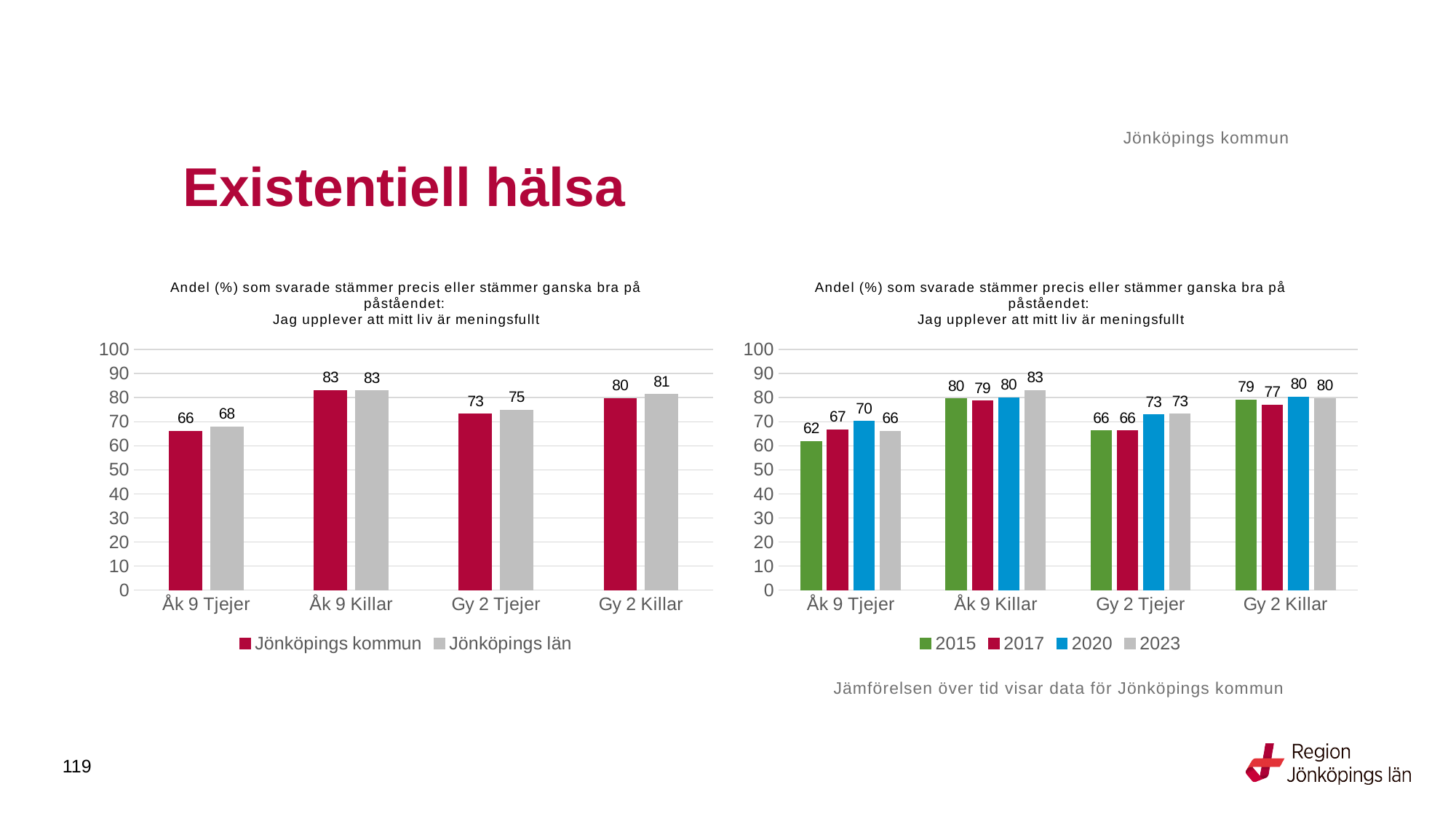
What kind of chart is the right chart? Bar chart In the left chart, what is the value for Jönköpings län for Gy 2 Tjejer? 75 In the left chart, what is the value for Jönköpings kommun for Åk 9 Tjejer? 66 In the right chart, which is larger for Åk 9 Tjejer: the 2020 value or the 2023 value? 2020 In the left chart, which category has the highest value for Jönköpings kommun? Åk 9 Killar In the left chart, how many series does the legend list? 2 In the right chart, what is the value for 2023 for Åk 9 Killar? 83 In the right chart, which category has the lowest value for 2017? Gy 2 Tjejer In the right chart, how many series does the legend list? 4 In the right chart, what is the difference between the 2020 and 2017 values for Gy 2 Tjejer? 7 In the right chart, what is the value for 2015 for Åk 9 Tjejer? 62 In the left chart, what is the difference between Jönköpings län and Jönköpings kommun for Åk 9 Tjejer? 2